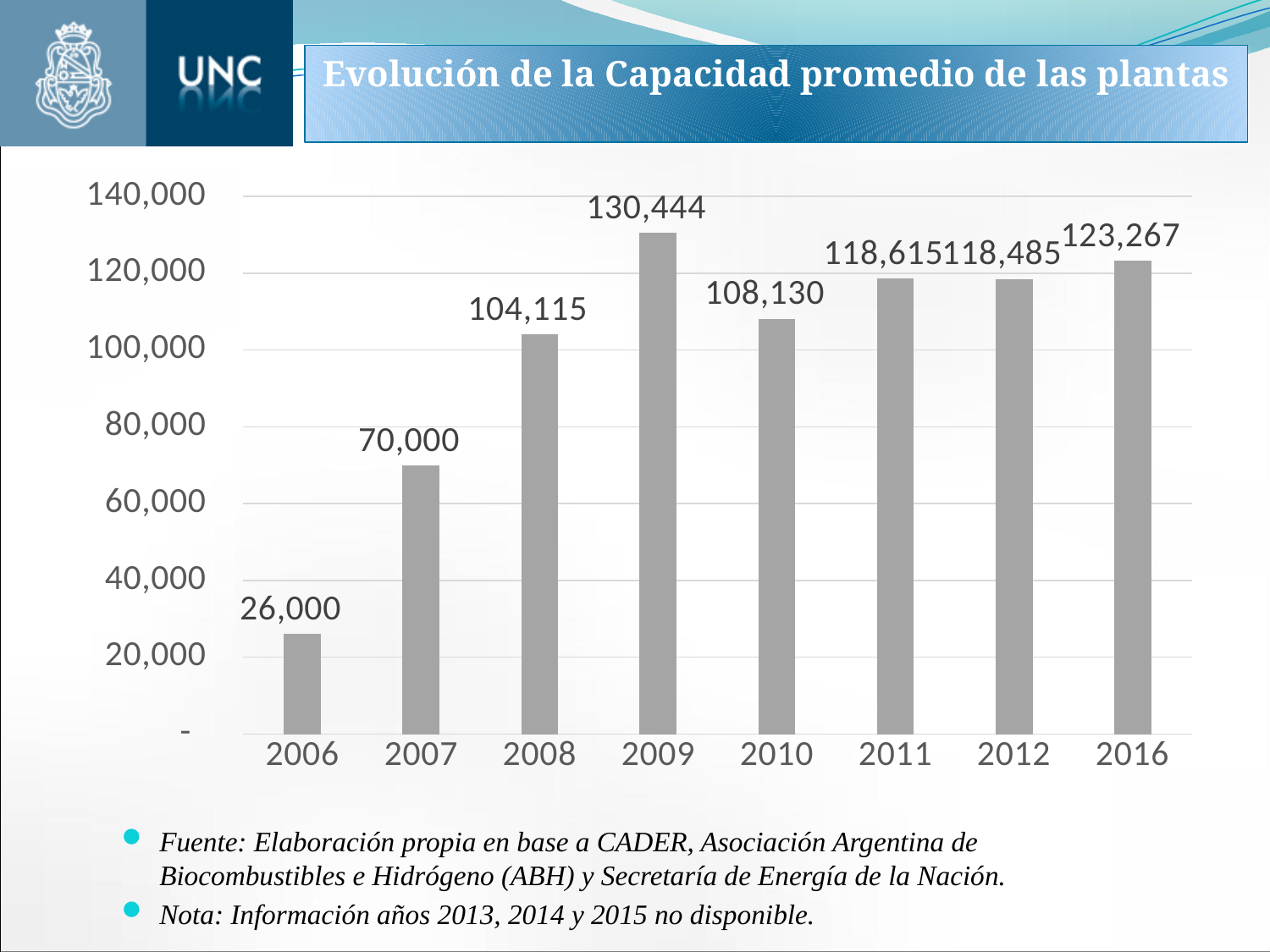
What is the value for 2010? 108,130 What is the value for 2006? 26,000 What is the difference between the values for 2007 and 2006? 44,000 Which year has the highest value? 2009 What kind of chart is shown on the slide? bar chart Which year has the lowest value? 2006 Which is larger, the value for 2009 or the value for 2016? 2009 What is the difference between the values for 2009 and 2006? 104,444 What is the value for 2009? 130,444 How many years are shown on the x axis? 8 Is the value for 2006 greater or less than 40,000? less What is the value for 2016? 123,267